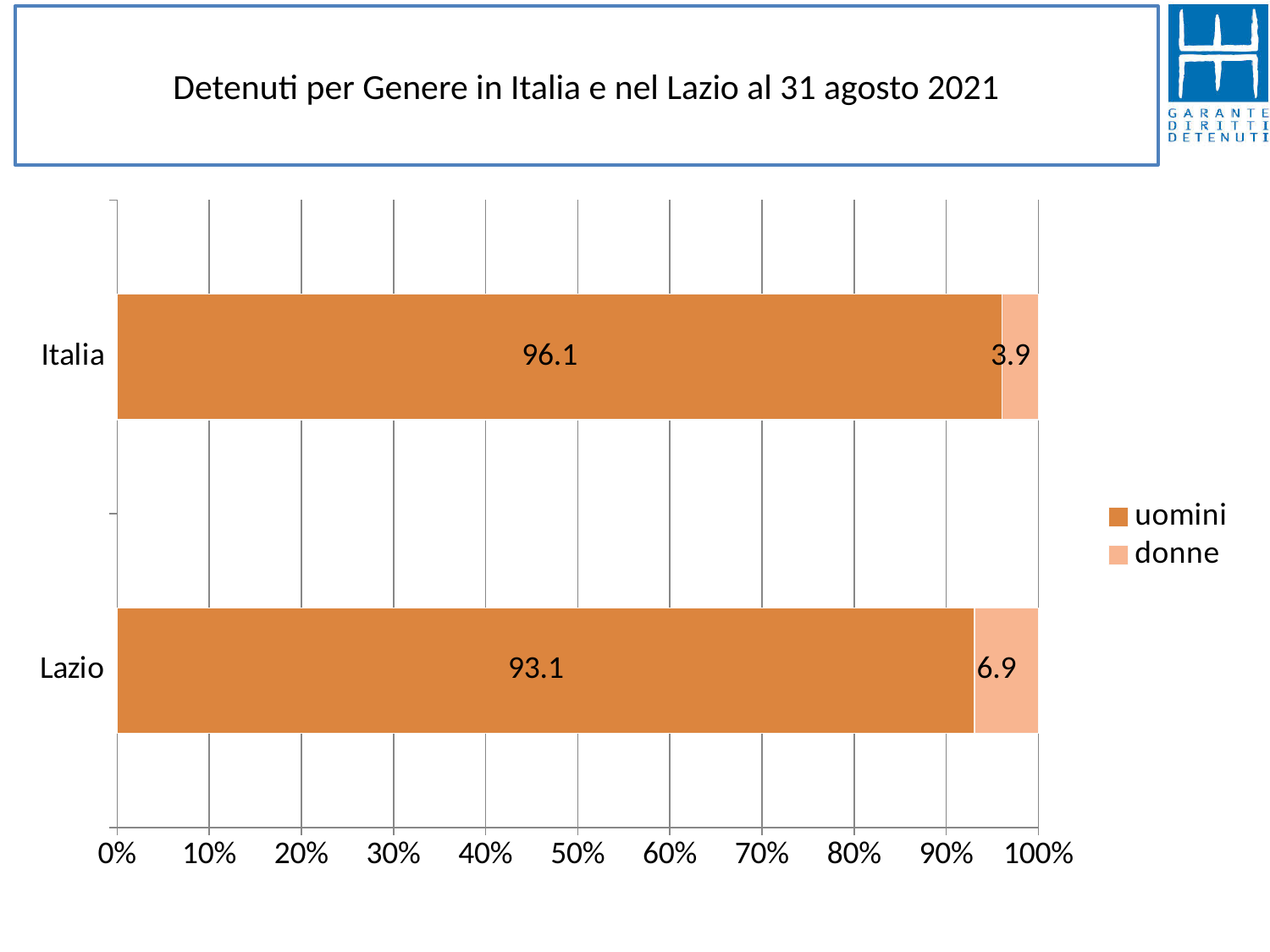
What is the value for donne in Italia? 3.9 What is the value for donne in Lazio? 6.9 How many categories are shown on the chart? 2 What is the difference between the uomini values for Italia and Lazio? 3.0 What is the value for uomini in Italia? 96.1 How many series does the legend list? 2 What is the title of the chart? Detenuti per Genere in Italia e nel Lazio al 31 agosto 2021 What is the difference between the donne values for Lazio and Italia? 3.0 Which category has the higher value for donne, Italia or Lazio? Lazio What kind of chart is shown on the slide? Stacked bar chart What is the value for uomini in Lazio? 93.1 Which category has the lowest value for uomini? Lazio